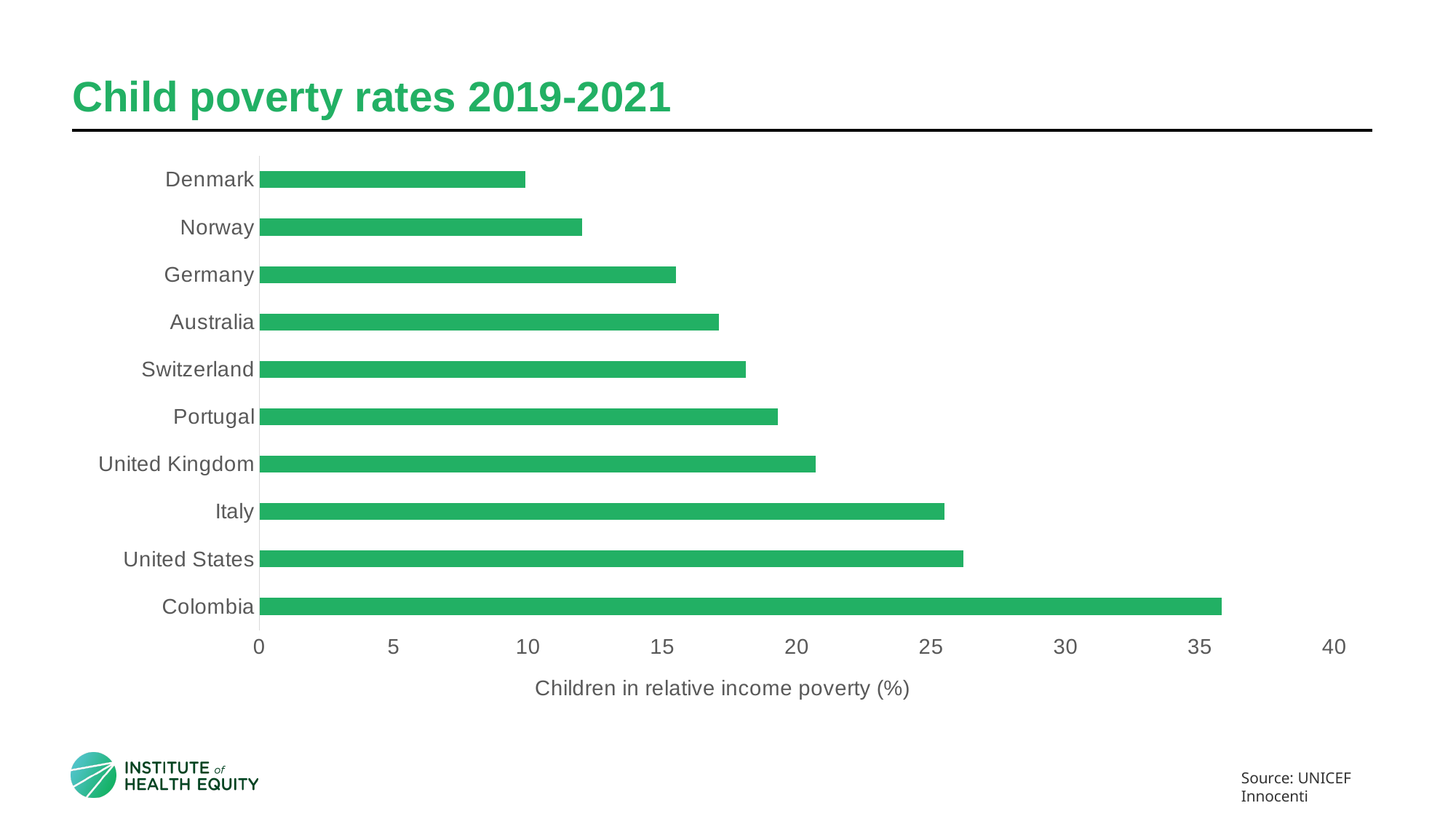
Which has a higher child poverty rate, Portugal or Norway? Portugal Which country has the lowest child poverty rate in the chart? Denmark Is the value for Germany greater or less than 15? greater Is the value for Colombia greater or less than 35? greater Which has a higher child poverty rate, Italy or Switzerland? Italy Is the value for Norway greater or less than 15? less Which country has the highest child poverty rate in the chart? Colombia What is the label of the horizontal axis? Children in relative income poverty (%) What kind of chart is shown on the slide? Bar chart How many countries are shown in the chart? 10